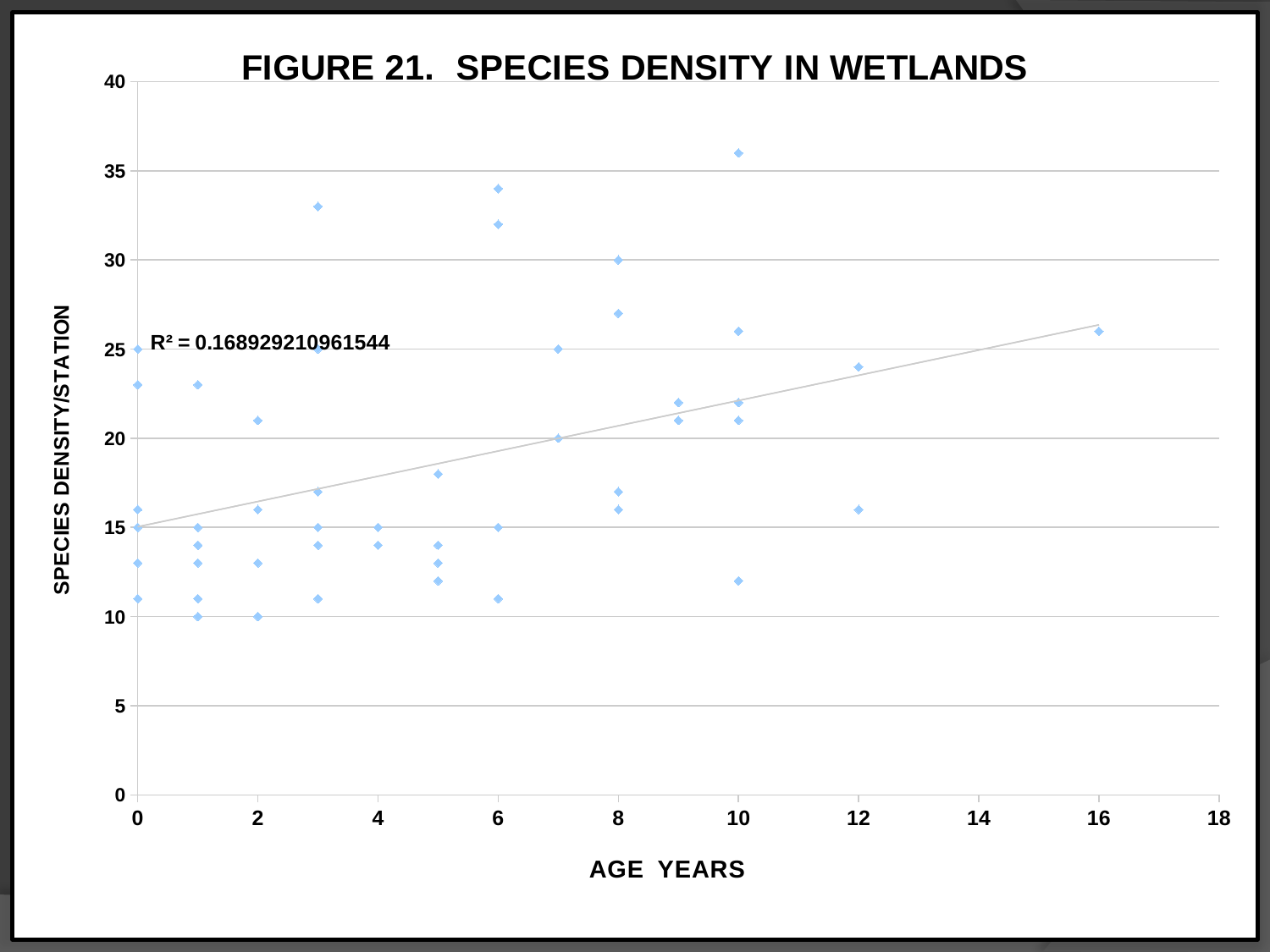
What is the highest species density value plotted at age 7 years? 25 Is the highest species density value at age 10 years greater or less than 35? greater What R² value is printed on the chart? 0.168929210961544 Is the highest species density value at age 3 years greater or less than 30? greater At which age in years does the highest species density point on the chart occur? 10 What kind of chart is shown on the slide? Scatter chart Does the trendline rise or fall as age in years increases? Rises Is the highest species density value at age 5 years greater or less than 20? less What is the label of the x axis? AGE YEARS What is the title of the chart? FIGURE 21. SPECIES DENSITY IN WETLANDS What is the lowest species density value plotted at age 2 years? 10 What is the highest species density value plotted at age 8 years? 30